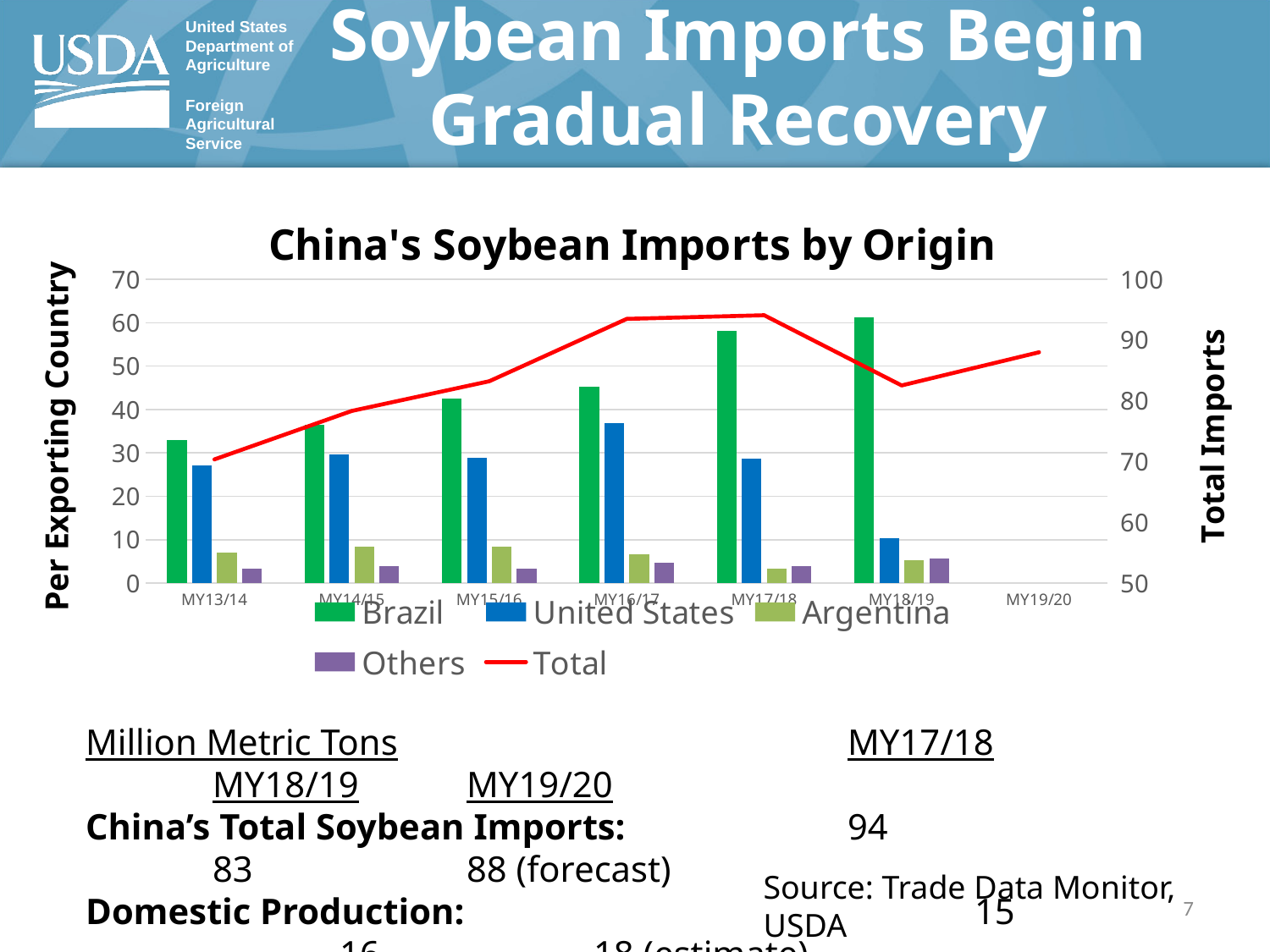
Is the value for the United States in MY18/19 greater or less than 20? less In which marketing year is the United States bar lowest? MY18/19 What kind of chart is 'China's Soybean Imports by Origin'? bar chart with a line In which marketing year is the Brazil bar highest? MY18/19 How many marketing years are shown on the x axis of 'China's Soybean Imports by Origin'? 7 Is the value for Brazil in MY18/19 greater or less than 50? greater In which marketing year is the Total line lowest? MY13/14 Does the Total line rise or fall from MY13/14 to MY17/18? rise In which marketing year is the United States bar highest? MY16/17 What is the label of the right-hand vertical axis? Total Imports How many series does the legend of 'China's Soybean Imports by Origin' list? 5 In MY16/17, which is larger: the Brazil bar or the United States bar? Brazil